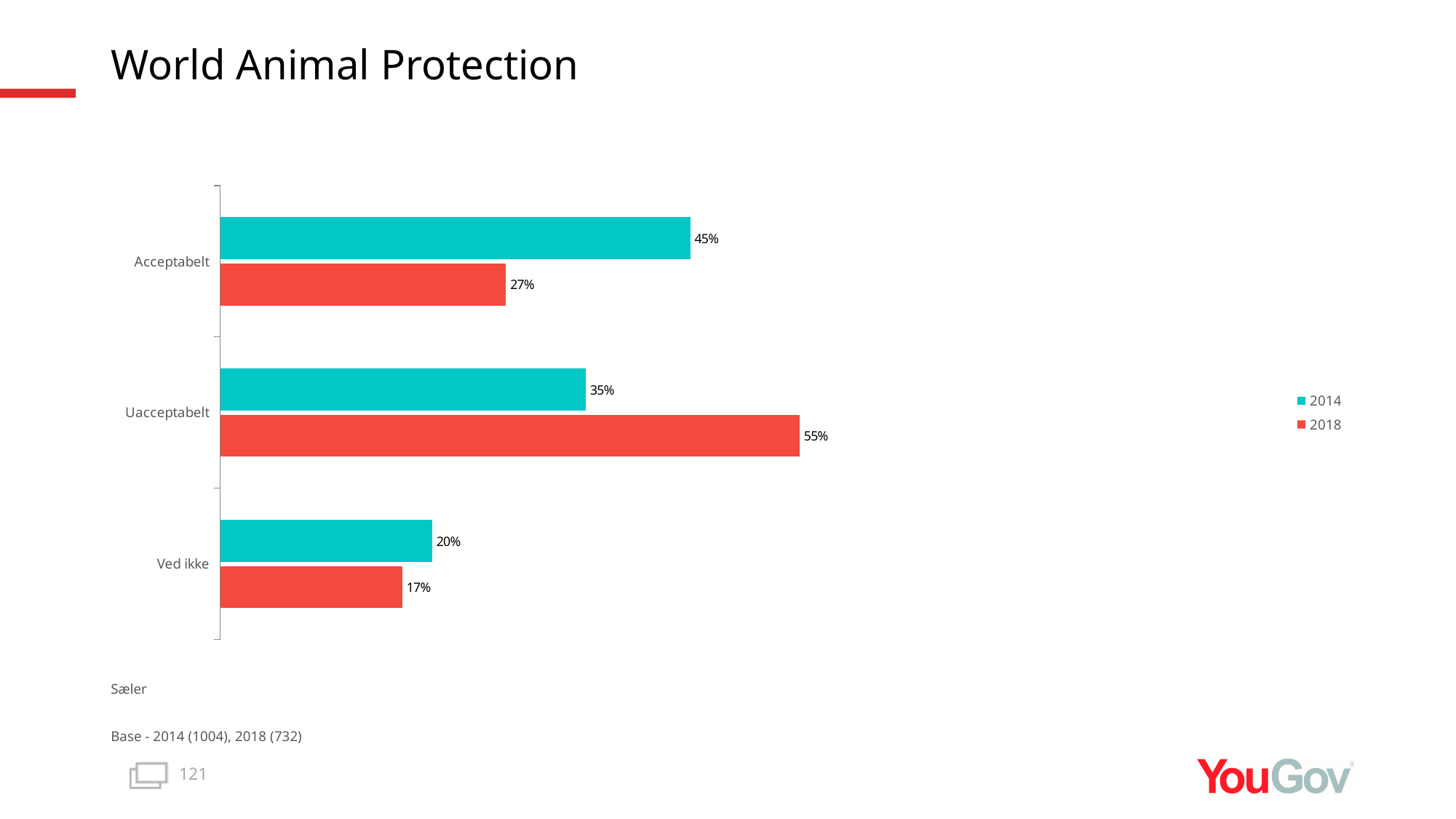
Which category has the highest 2018 value? Uacceptabelt Which series is shown in red? 2018 What is the 2014 value for Uacceptabelt? 35% What is the 2014 value for Acceptabelt? 45% What is the 2018 value for Uacceptabelt? 55% How many categories are shown on the chart? 3 What is the difference between the 2014 and 2018 values for Acceptabelt? 18 percentage points Which category has the lowest 2014 value? Ved ikke What is the 2018 value for Ved ikke? 17% What kind of chart is shown on the slide? Bar chart Which is larger for Uacceptabelt, the 2014 value or the 2018 value? 2018 How many series does the legend list? 2